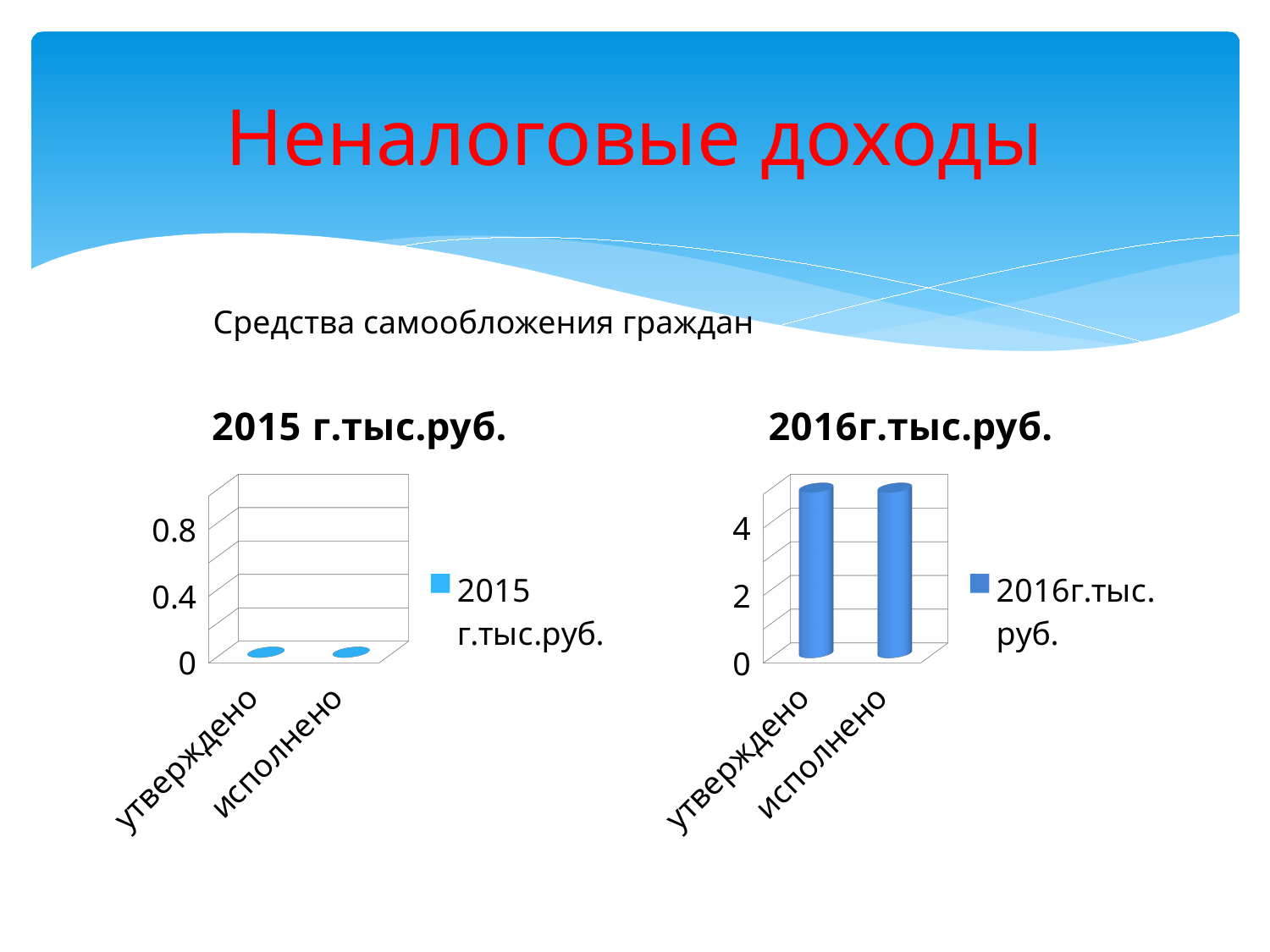
How many series does the legend of the "2016г.тыс.руб." chart list? 1 What is the legend entry of the "2015 г.тыс.руб." chart? 2015 г.тыс.руб. What kind of chart is the "2016г.тыс.руб." chart? bar chart In the "2015 г.тыс.руб." chart, is the value for утверждено greater or less than 0.4? less What kind of chart is the "2015 г.тыс.руб." chart? bar chart In the "2015 г.тыс.руб." chart, what value does the bar for исполнено show? 0 What are the two category labels on the x axis of the "2016г.тыс.руб." chart? утверждено, исполнено In the "2016г.тыс.руб." chart, is the value for исполнено greater or less than 2? greater How many categories are shown on the x axis of the "2016г.тыс.руб." chart? 2 How many categories are shown on the x axis of the "2015 г.тыс.руб." chart? 2 What is the title of the chart on the right side of the slide? 2016г.тыс.руб. In the "2016г.тыс.руб." chart, is the value for утверждено greater or less than 4? greater